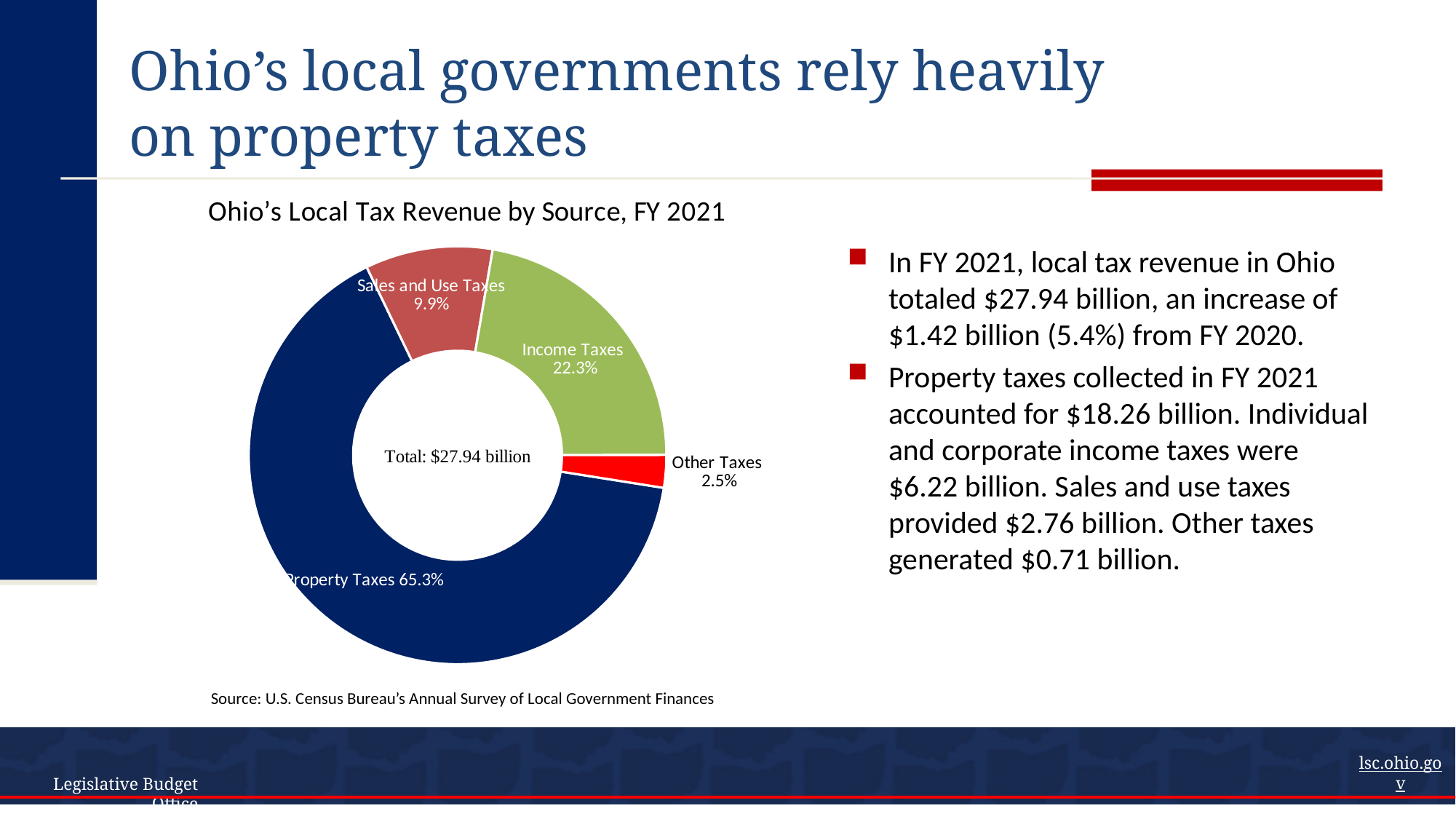
What share of Ohio's local tax revenue in FY 2021 came from Other Taxes? 2.5% Which revenue source has the largest share in the chart? Property Taxes What is the title of the chart? Ohio's Local Tax Revenue by Source, FY 2021 What share of Ohio's local tax revenue in FY 2021 came from Income Taxes? 22.3% Which revenue source has the smallest share in the chart? Other Taxes How many revenue sources are shown in the chart? 4 What is the difference in percentage points between the Property Taxes share and the Income Taxes share? 43 percentage points What share of Ohio's local tax revenue in FY 2021 came from Sales and Use Taxes? 9.9% What kind of chart is used to show Ohio's local tax revenue by source? Doughnut (pie) chart Which has a larger share, Income Taxes or Sales and Use Taxes? Income Taxes What total is printed in the center of the chart? Total: $27.94 billion What share of Ohio's local tax revenue in FY 2021 came from Property Taxes? 65.3%